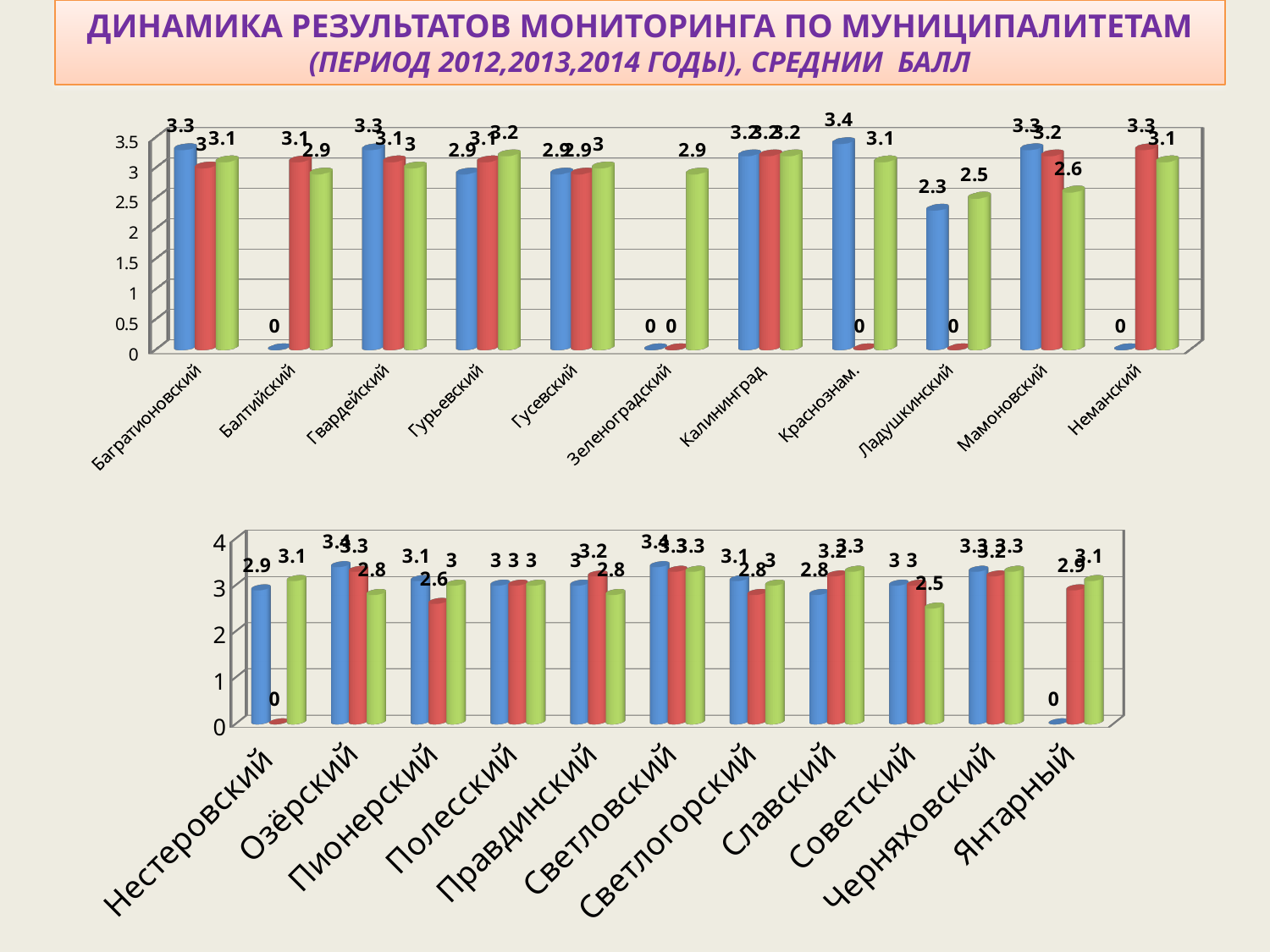
In the bottom chart, what is the difference between the blue bar and the green bar for Озёрский? 0.6 What type of chart is the top chart? bar chart In the top chart, what is the value of the green bar for Зеленоградский? 2.9 In the top chart, which municipality has the highest blue bar? Краснознам. In the top chart, what is the difference between the blue bar and the green bar for Мамоновский? 0.7 In the top chart, what is the value of the blue bar for Ладушкинский? 2.3 In the bottom chart, is the red bar for Славский greater or less than 3? greater In the bottom chart, what is the value of the green bar for Советский? 2.5 In the bottom chart, which municipality has the lowest green bar? Советский In the top chart, which is larger for Гурьевский: the blue bar or the green bar? the green bar In the bottom chart, what is the value of the red bar for Пионерский? 2.6 How many municipalities are shown on the x axis of the bottom chart? 11